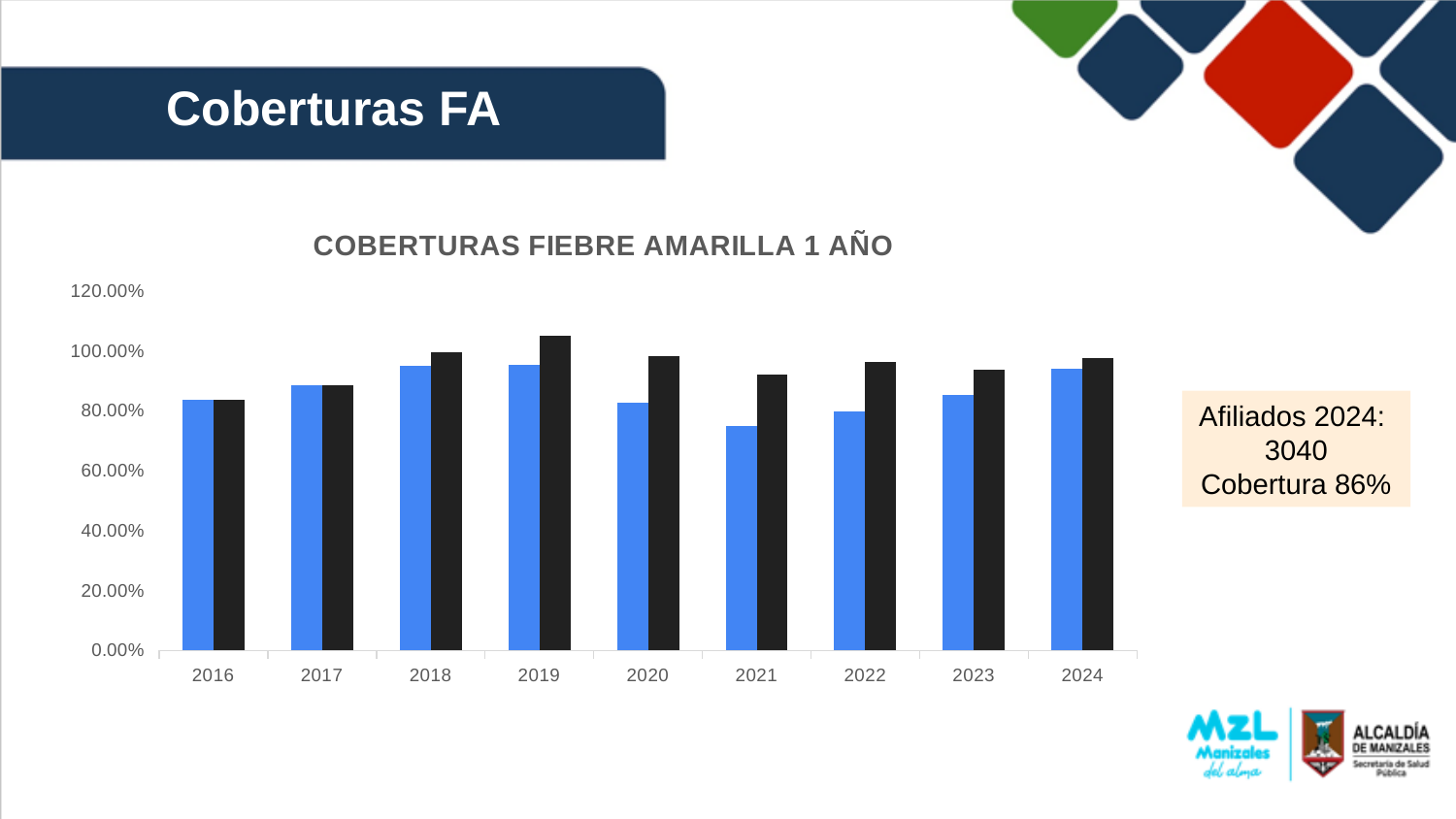
What two colours are used for the bars in the chart? blue and black Do the blue bars rise or fall from 2021 to 2024? rise Which is larger, the blue bar for 2018 or the blue bar for 2021? 2018 How many years are shown on the x axis of the chart? 9 What kind of chart is shown on the slide? bar chart Is the value of the blue bar for 2018 greater or less than 80.00%? greater Is the value of the black bar for 2021 greater or less than 80.00%? greater In which year is the blue bar the lowest? 2021 In which year is the black bar the highest? 2019 Is the value of the black bar for 2019 greater or less than 100.00%? greater What is the title of the chart? COBERTURAS FIEBRE AMARILLA 1 AÑO